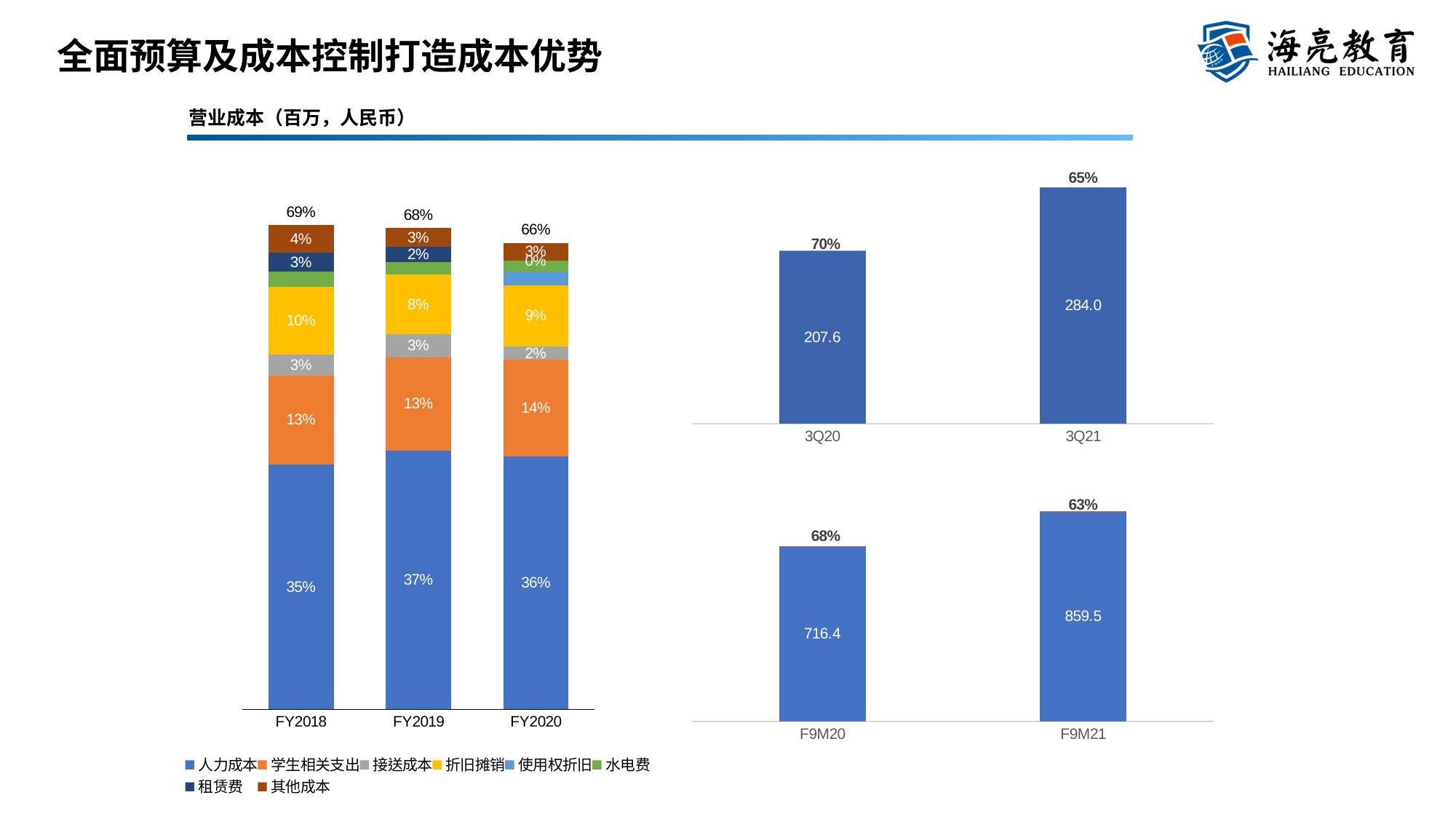
In the stacked bar chart on the left, what percentage does 人力成本 account for in FY2019? 37% In the stacked bar chart on the left, which fiscal year has the highest share for 学生相关支出? FY2020 What kind of chart is the bottom-right chart? bar chart How many series does the legend of the stacked bar chart on the left list? 8 In the stacked bar chart on the left, what percentage does 折旧摊销 account for in FY2018? 10% In the top-right chart, what is the value for 3Q21? 284.0 In the top-right chart, what is the difference between the values for 3Q21 and 3Q20? 76.4 In the stacked bar chart on the left, what is the percentage label shown above the FY2020 bar? 66% How many fiscal years are shown on the x axis of the stacked bar chart on the left? 3 In the bottom-right chart, what is the value for F9M20? 716.4 In the top-right chart, what is the percentage label above the 3Q20 bar? 70% In the bottom-right chart, what is the difference between the values for F9M21 and F9M20? 143.1